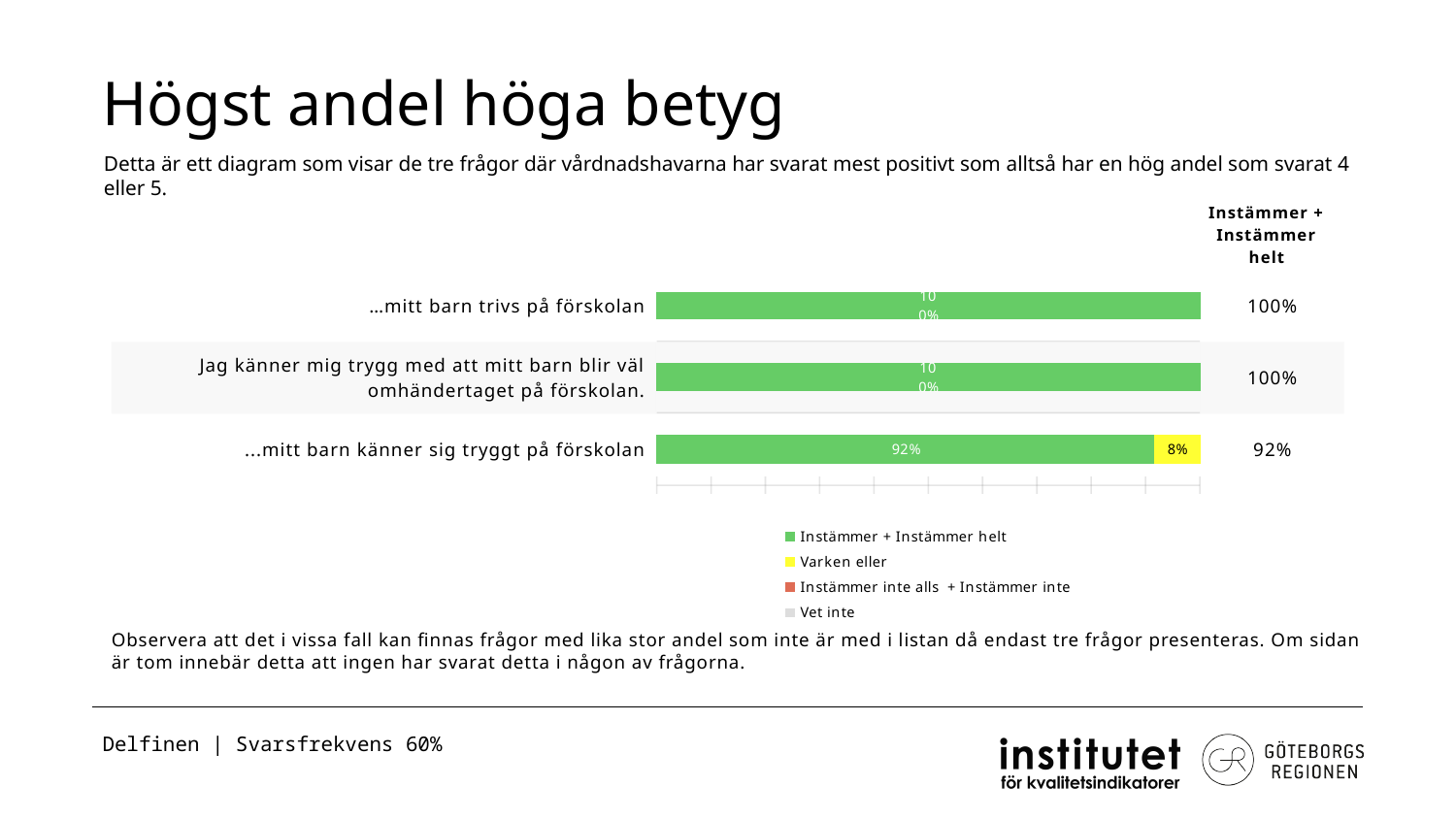
What is the 'Instämmer + Instämmer helt' value shown for '…mitt barn trivs på förskolan'? 100% Which category has the lowest 'Instämmer + Instämmer helt' share? …mitt barn känner sig tryggt på förskolan What kind of chart is shown on the slide? bar chart What is the 'Instämmer + Instämmer helt' share for '…mitt barn känner sig tryggt på förskolan'? 92% Which is larger: the 'Instämmer + Instämmer helt' share for '…mitt barn känner sig tryggt på förskolan' or its 'Varken eller' share? Instämmer + Instämmer helt What is the total of the stacked bar for '…mitt barn känner sig tryggt på förskolan'? 100% What colour represents 'Varken eller' in the chart? yellow How many categories (questions) are plotted in the chart? 3 How many series does the legend list? 4 What is the 'Instämmer + Instämmer helt' value shown for 'Jag känner mig trygg med att mitt barn blir väl omhändertaget på förskolan.'? 100% What is the difference between the 'Instämmer + Instämmer helt' share for '…mitt barn trivs på förskolan' and for '…mitt barn känner sig tryggt på förskolan'? 8% What is the 'Varken eller' share for '…mitt barn känner sig tryggt på förskolan'? 8%